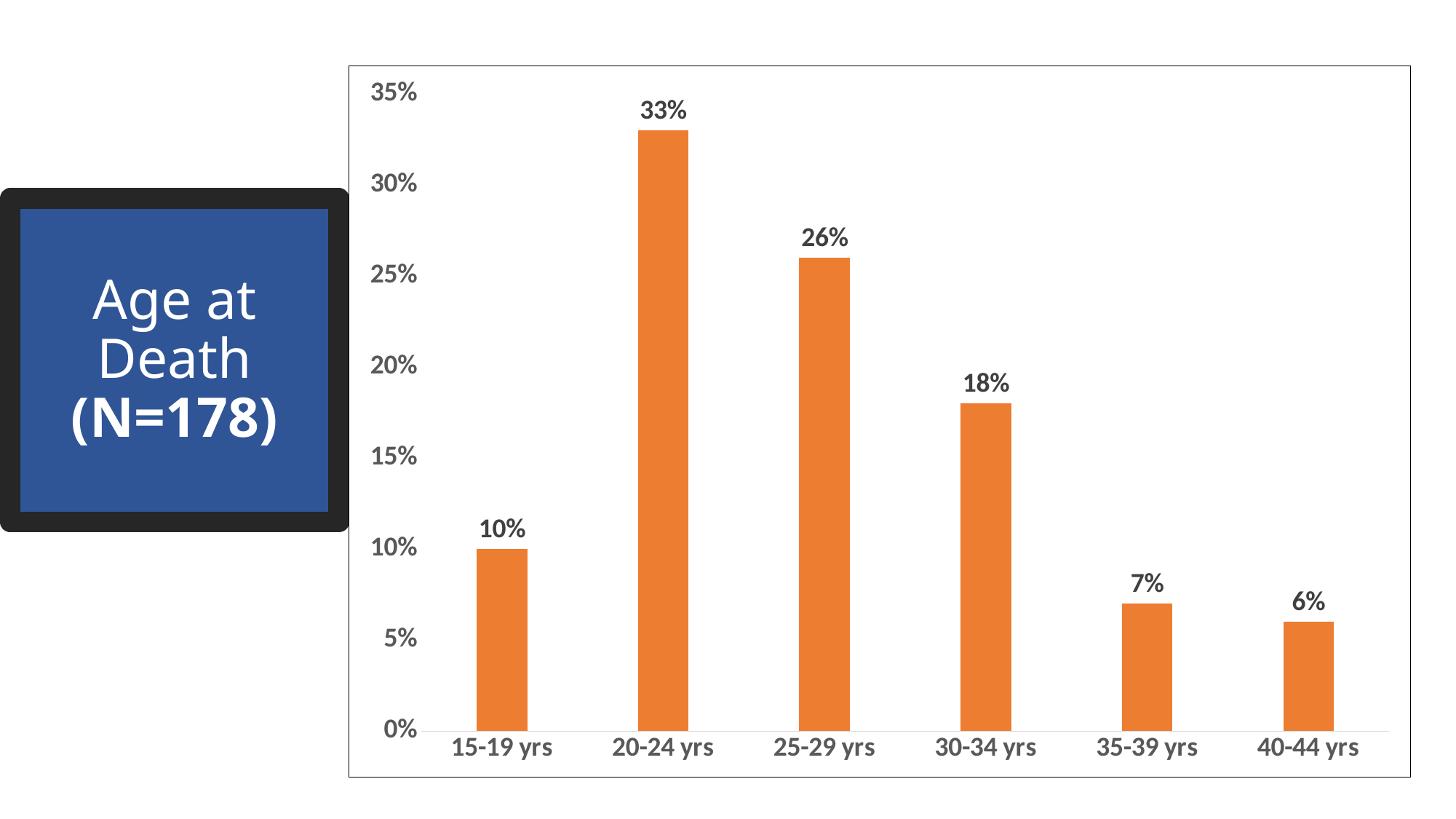
What is the sample size (N) stated in the title box next to the chart? 178 Is the value for 30-34 yrs greater or less than 20%? less Which age group has the lowest percentage of deaths? 40-44 yrs What is the difference between the values for 20-24 yrs and 25-29 yrs? 7% What is the value shown for the 35-39 yrs age group? 7% Which is larger, the value for 25-29 yrs or the value for 30-34 yrs? 25-29 yrs What percentage of deaths occurred in the 20-24 yrs age group? 33% How many age groups are shown on the chart? 6 What is the value shown for the 15-19 yrs age group? 10% What kind of chart is shown on the slide? Bar chart What is the difference between the values for 30-34 yrs and 40-44 yrs? 12% Which age group has the highest percentage of deaths? 20-24 yrs